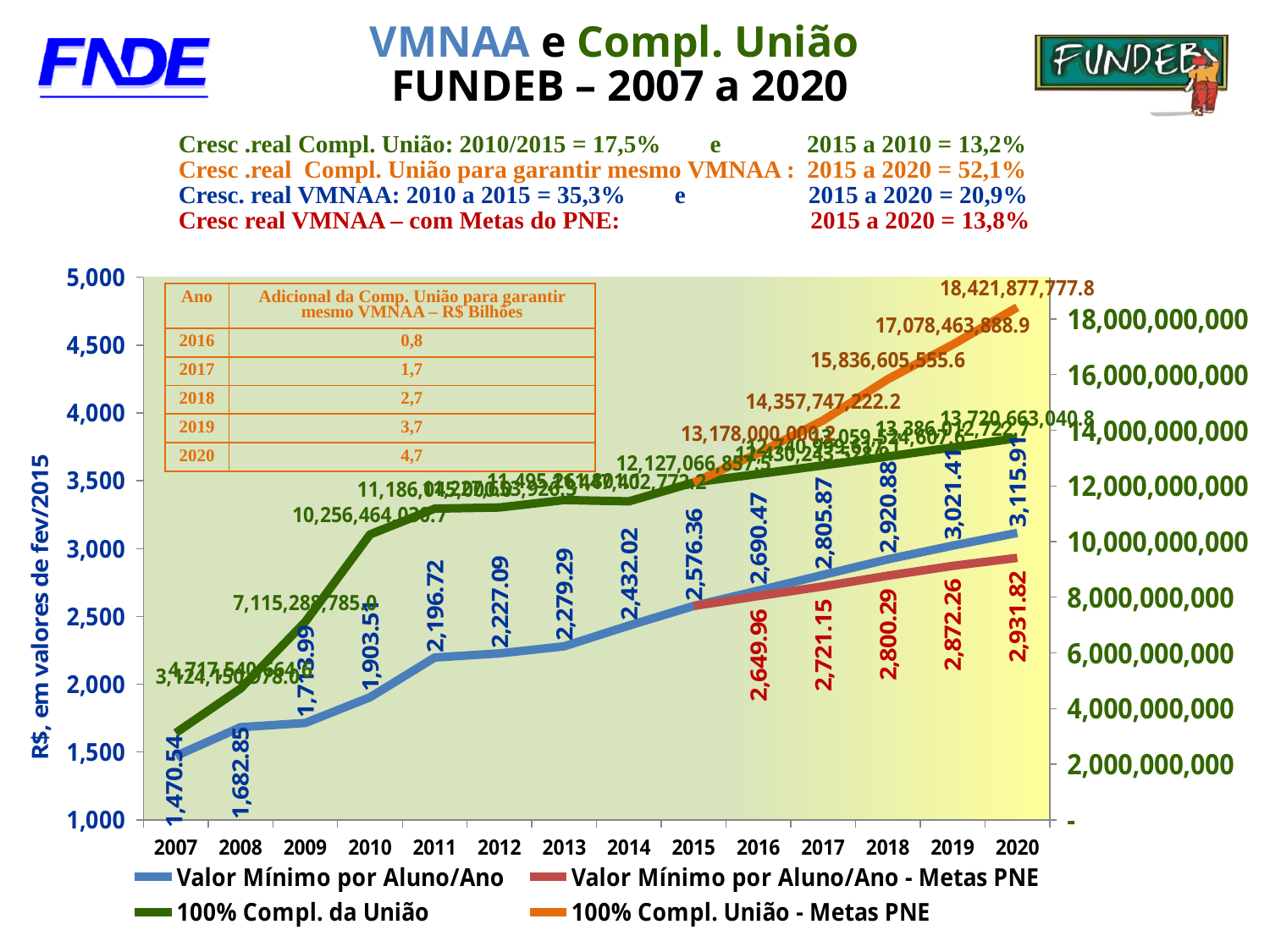
What is the value of Valor Mínimo por Aluno/Ano in 2020? 3,115.91 What is the value of Valor Mínimo por Aluno/Ano - Metas PNE in 2020? 2,931.82 What is the value of Valor Mínimo por Aluno/Ano - Metas PNE in 2016? 2,649.96 In which year is Valor Mínimo por Aluno/Ano lowest? 2007 How many series does the chart legend list? 4 What type of chart is shown on the slide? line chart What is the title of the left vertical axis? R$, em valores de fev/2015 Does the Valor Mínimo por Aluno/Ano series rise or fall from 2007 to 2020? rise What is the difference between Valor Mínimo por Aluno/Ano and Valor Mínimo por Aluno/Ano - Metas PNE in 2020? 184.09 What is the value of Valor Mínimo por Aluno/Ano in 2007? 1,470.54 In 2018, which is larger: Valor Mínimo por Aluno/Ano or Valor Mínimo por Aluno/Ano - Metas PNE? Valor Mínimo por Aluno/Ano How many years are shown on the x axis of the chart? 14